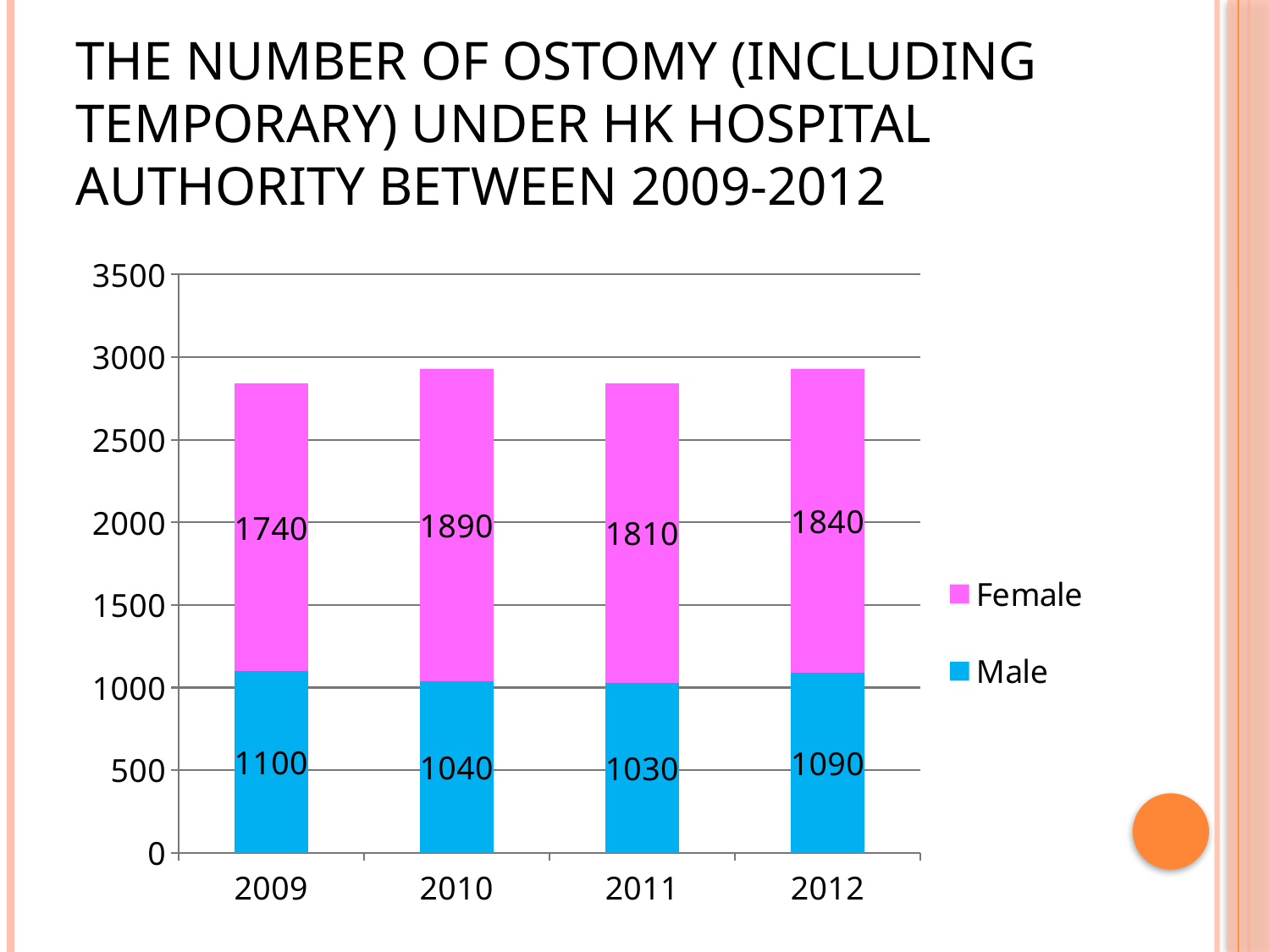
Which year has the lowest Male value? 2011 What is the difference between the Female values for 2010 and 2009? 150 How many years are shown on the x axis? 4 How many series does the legend list? 2 What is the Male value for 2011? 1030 What is the Male value for 2009? 1100 Is the Male value for 2012 larger than the Male value for 2010? Yes What kind of chart is shown on the slide? Stacked bar chart What is the total of the stacked bar for 2012? 2930 Which year has the highest Female value? 2010 What is the total of the stacked bar for 2009? 2840 What is the Female value for 2010? 1890